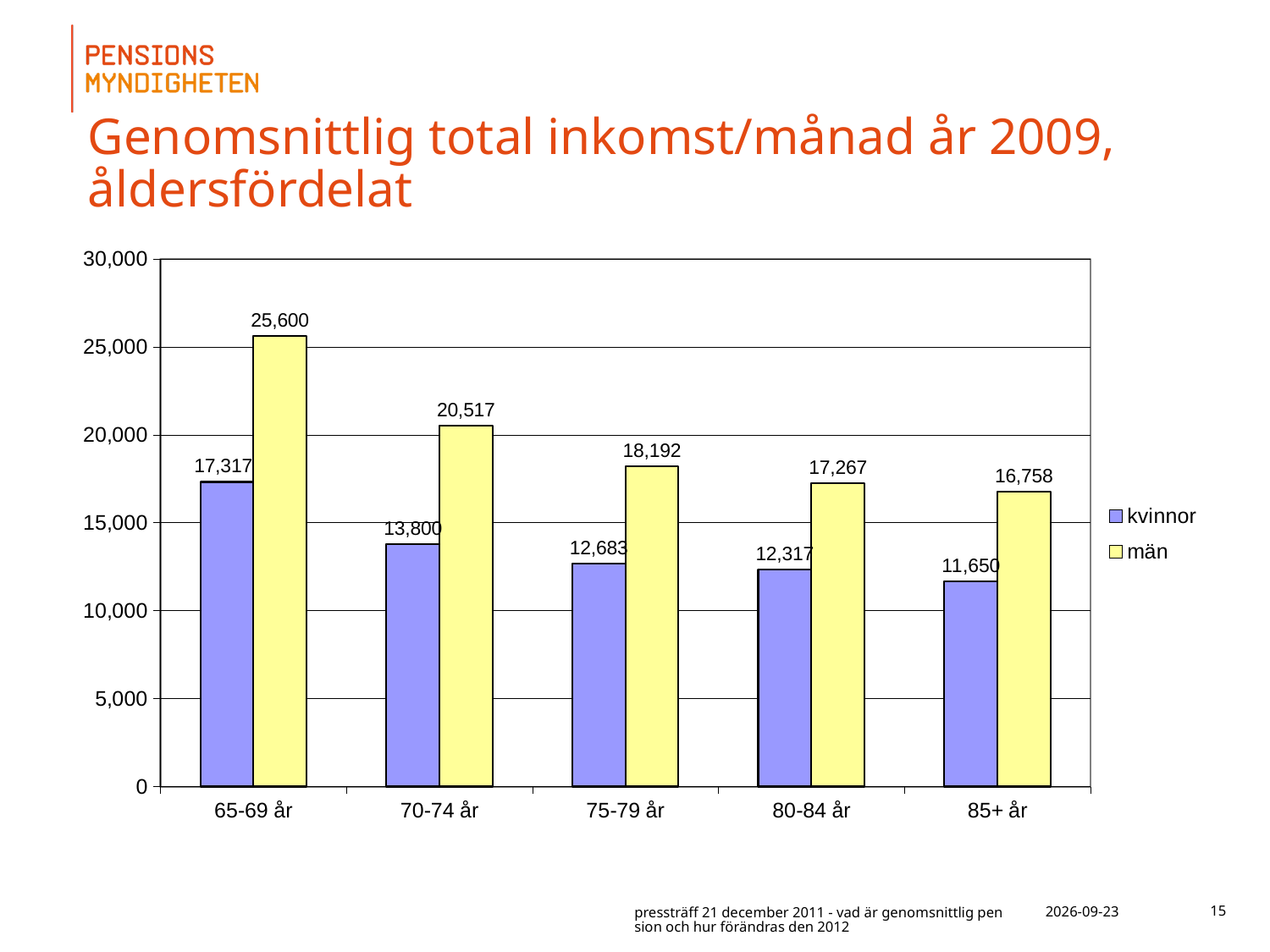
Which age group has the lowest value for kvinnor? 85+ år Which age group has the highest value for män? 65-69 år How many series does the legend list? 2 Is the value for män in the 70-74 år age group greater or less than 20,000? greater Do the values for kvinnor rise or fall from 65-69 år to 85+ år? fall How many age groups are shown on the x axis? 5 What is the value for kvinnor in the 85+ år age group? 11,650 What is the value for kvinnor in the 65-69 år age group? 17,317 Which is larger in the 80-84 år age group, kvinnor or män? män What is the difference between män and kvinnor in the 65-69 år age group? 8,283 What is the value for män in the 75-79 år age group? 18,192 What kind of chart is shown on the slide? bar chart